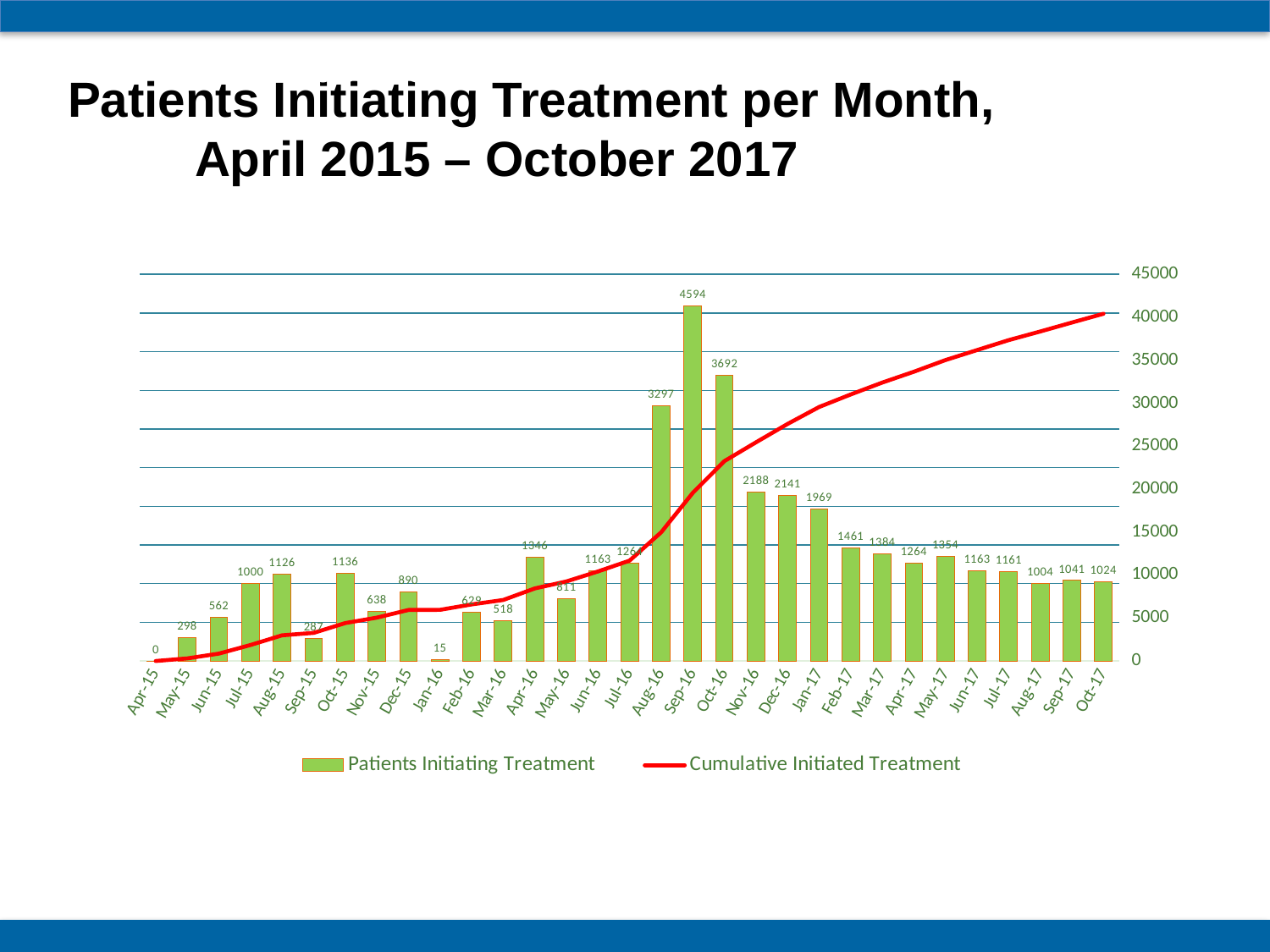
Which month has the highest number of patients initiating treatment? Sep-16 What is the value of the Patients Initiating Treatment bar for Nov-16? 2188 Is the Cumulative Initiated Treatment value at Oct-17 greater or less than 35000? greater Does the Cumulative Initiated Treatment line rise or fall from Apr-15 to Oct-17? Rise How many months are shown on the x axis of the chart? 31 How many series does the legend list? 2 How many patients initiated treatment in Sep-16? 4594 What is the difference between the patients initiating treatment in Sep-16 and Oct-16? 902 How many patients initiated treatment in Oct-17? 1024 What kind of chart is used to show Patients Initiating Treatment? Bar chart Which month has the lowest number of patients initiating treatment? Apr-15 Which month had more patients initiating treatment, Aug-16 or Oct-16? Oct-16